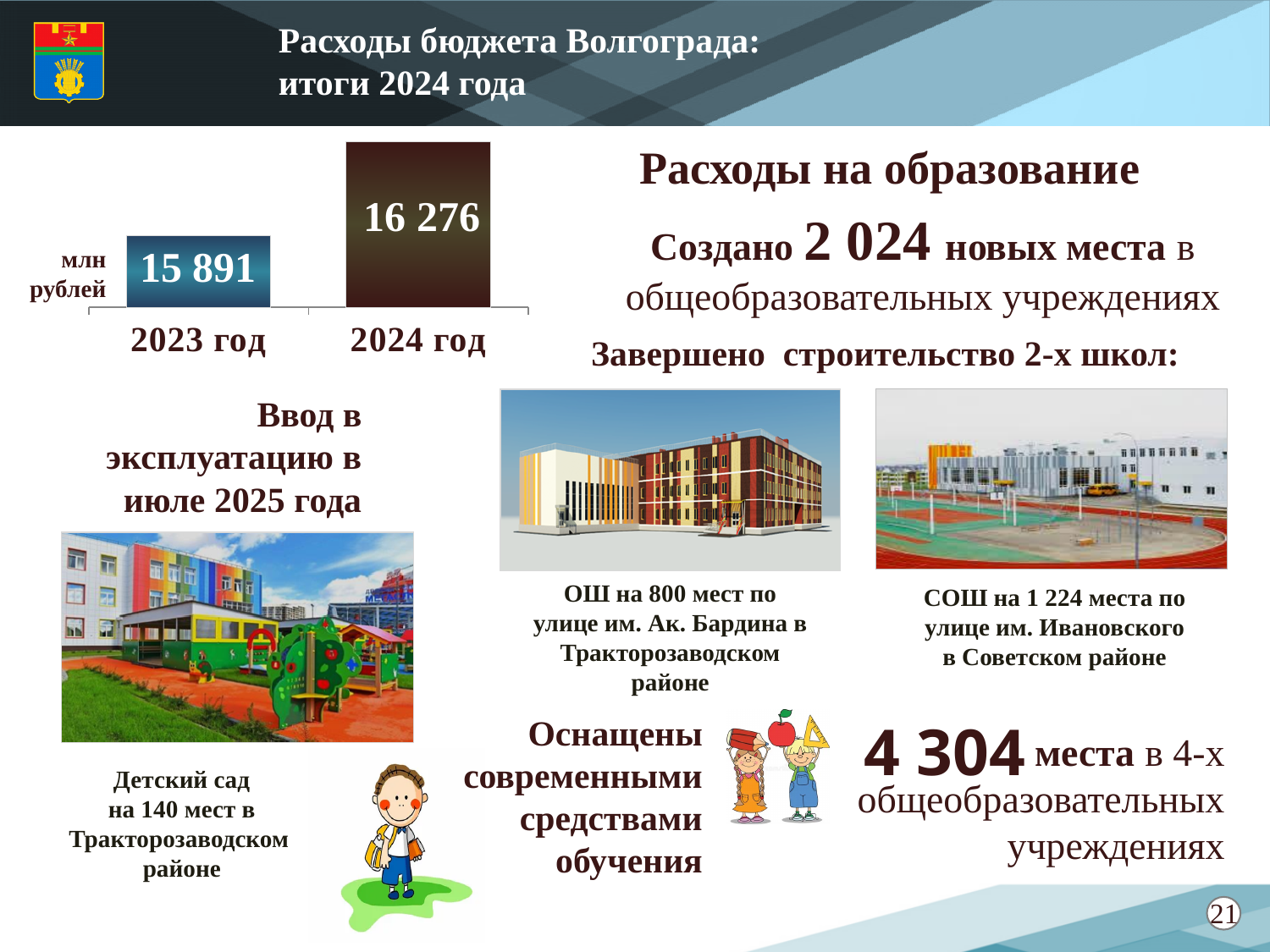
What type of chart is shown on the slide? bar chart Do the values in the chart rise or fall from 2023 год to 2024 год? rise In what units are the values in the bar chart expressed? млн рублей What is the title of the section the bar chart belongs to? Расходы на образование Which year has the higher value in the bar chart? 2024 год Which year has the lower value in the bar chart? 2023 год Is the value for 2024 год larger or smaller than the value for 2023 год? larger What is the value for 2024 год in the bar chart? 16 276 What is the value for 2023 год in the bar chart? 15 891 How many bars are shown in the chart? 2 By how much does the value for 2024 год exceed the value for 2023 год in the bar chart? 385